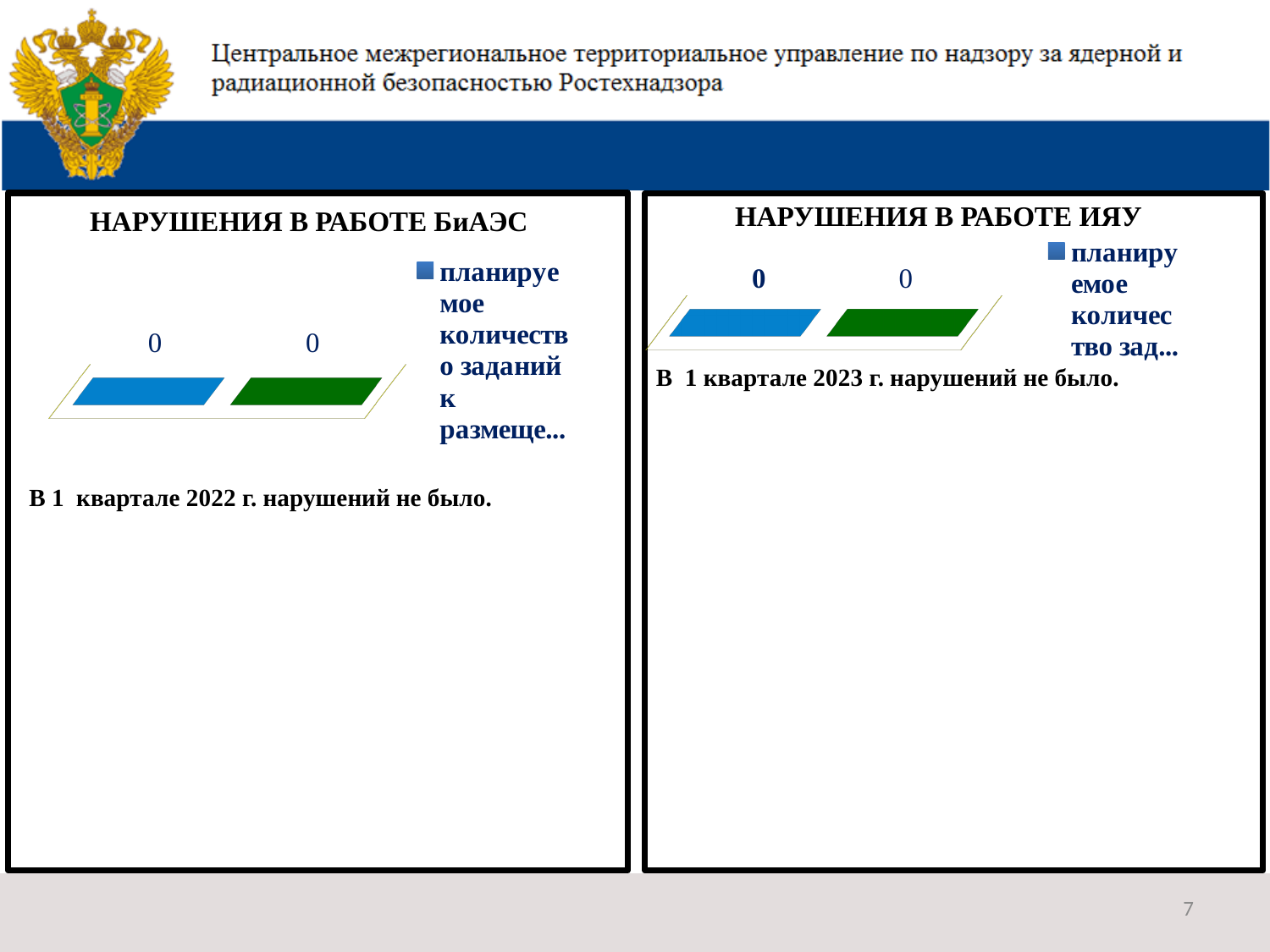
In the left chart "НАРУШЕНИЯ В РАБОТЕ БиАЭС", how many bars are plotted? 2 How many entries does the legend of the left chart "НАРУШЕНИЯ В РАБОТЕ БиАЭС" list? 1 In the right chart "НАРУШЕНИЯ В РАБОТЕ ИЯУ", what value is labelled on the green bar? 0 What kind of chart is shown in the right chart titled "НАРУШЕНИЯ В РАБОТЕ ИЯУ"? Bar chart In the left chart "НАРУШЕНИЯ В РАБОТЕ БиАЭС", what value is labelled on the green bar? 0 In the left chart "НАРУШЕНИЯ В РАБОТЕ БиАЭС", what is the difference between the values of the blue bar and the green bar? 0 In the right chart "НАРУШЕНИЯ В РАБОТЕ ИЯУ", what value is labelled on the blue bar? 0 In the right chart "НАРУШЕНИЯ В РАБОТЕ ИЯУ", how many bars are plotted? 2 In the left chart "НАРУШЕНИЯ В РАБОТЕ БиАЭС", what value is labelled on the blue bar? 0 What is the title of the chart on the right side of the slide? НАРУШЕНИЯ В РАБОТЕ ИЯУ In the right chart "НАРУШЕНИЯ В РАБОТЕ ИЯУ", what is the sum of the two bar values? 0 What kind of chart is shown in the left chart titled "НАРУШЕНИЯ В РАБОТЕ БиАЭС"? Bar chart